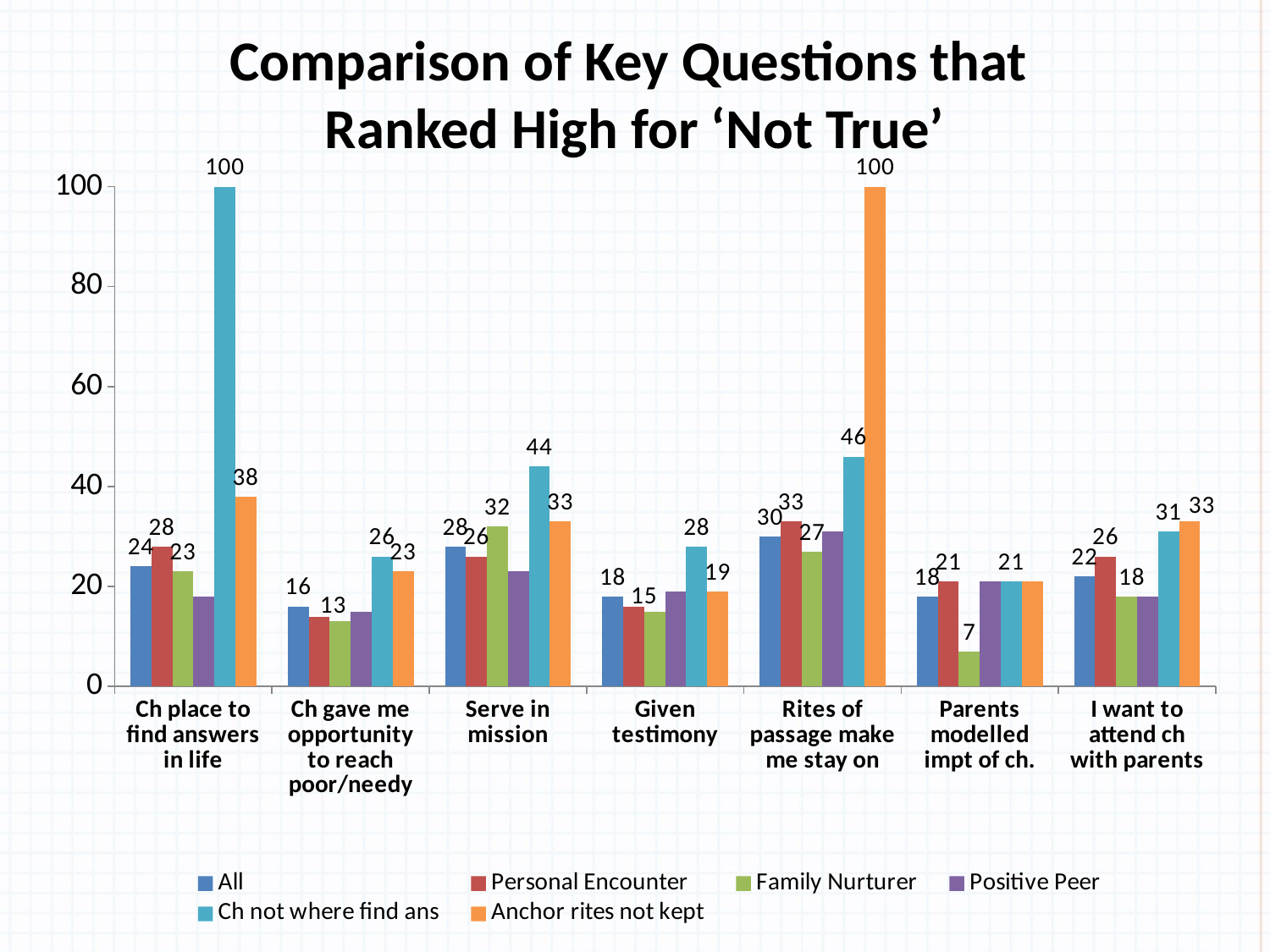
In the 'Rites of passage make me stay on' category, which is larger: 'Anchor rites not kept' or 'Ch not where find ans'? Anchor rites not kept What is the value for 'Anchor rites not kept' in the 'Rites of passage make me stay on' category? 100 What is the value for 'Ch not where find ans' in the 'Ch place to find answers in life' category? 100 What kind of chart is shown on the slide? bar chart How many categories are shown on the x axis? 7 What is the value for 'Ch not where find ans' in the 'Serve in mission' category? 44 Which category has the highest value for the 'All' series? Rites of passage make me stay on Is the value for 'Positive Peer' in the 'Rites of passage make me stay on' category greater or less than 20? greater What is the value for 'Family Nurturer' in the 'Parents modelled impt of ch.' category? 7 How many series does the legend list? 6 In the 'Ch place to find answers in life' category, what is the difference between 'Ch not where find ans' and 'Anchor rites not kept'? 62 In which category is the 'Family Nurturer' value lowest? Parents modelled impt of ch.